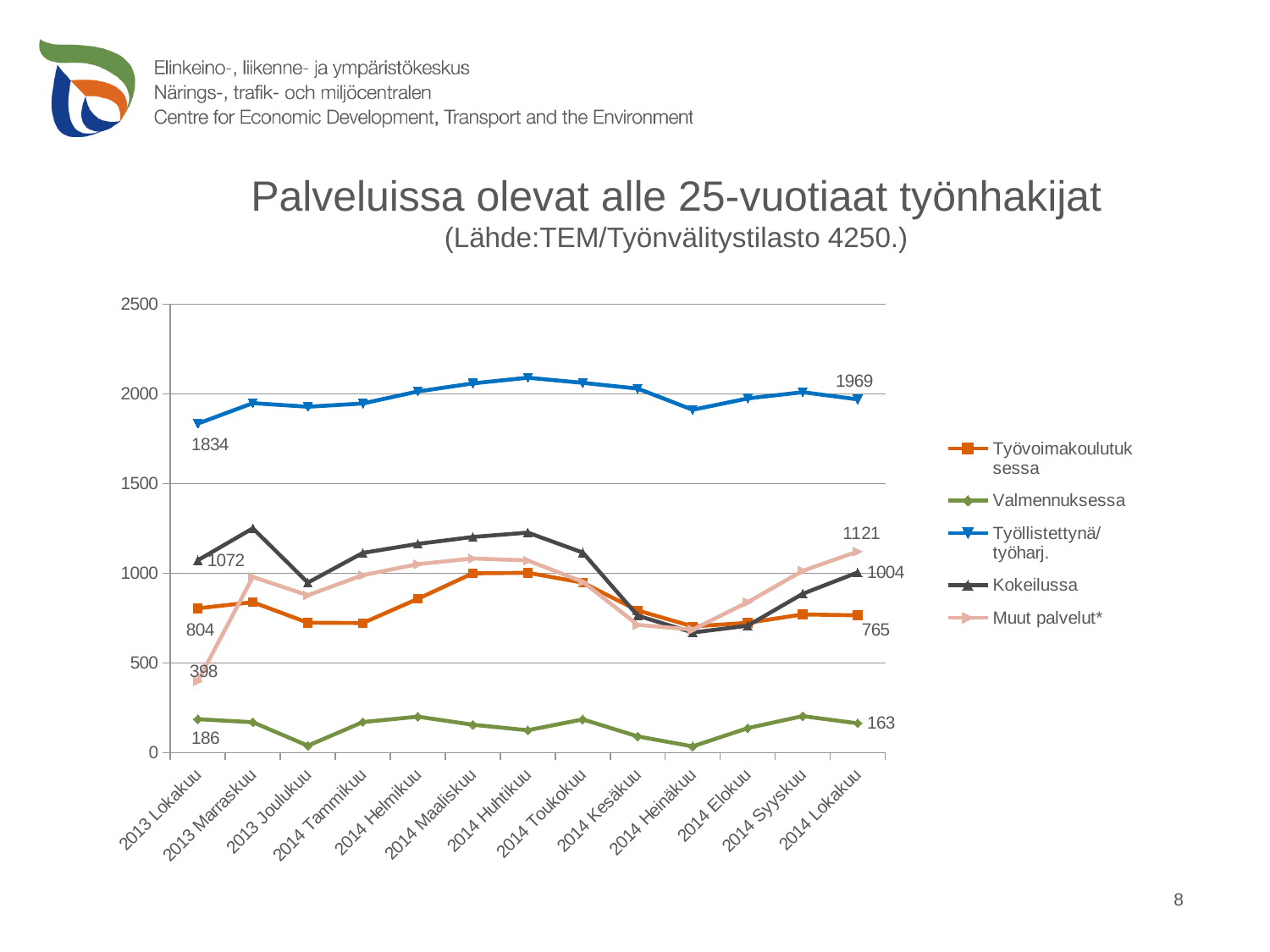
Which is larger in 2014 Lokakuu: Työvoimakoulutuksessa or Muut palvelut*? Muut palvelut* Which series has the highest value in 2014 Lokakuu? Työllistettynä/työharj. Which series has the lowest value in 2013 Lokakuu? Valmennuksessa What is the value for Työllistettynä/työharj. in 2013 Lokakuu? 1834 What is the value for Muut palvelut* in 2014 Lokakuu? 1121 What is the value for Työllistettynä/työharj. in 2014 Lokakuu? 1969 Is the value for Kokeilussa in 2013 Marraskuu greater or less than 1000? greater How many months are shown on the x axis? 13 What type of chart is shown on the slide? line chart What is the value for Valmennuksessa in 2013 Lokakuu? 186 What is the difference between the Kokeilussa values in 2013 Lokakuu and 2014 Lokakuu? 68 How many series does the legend list? 5